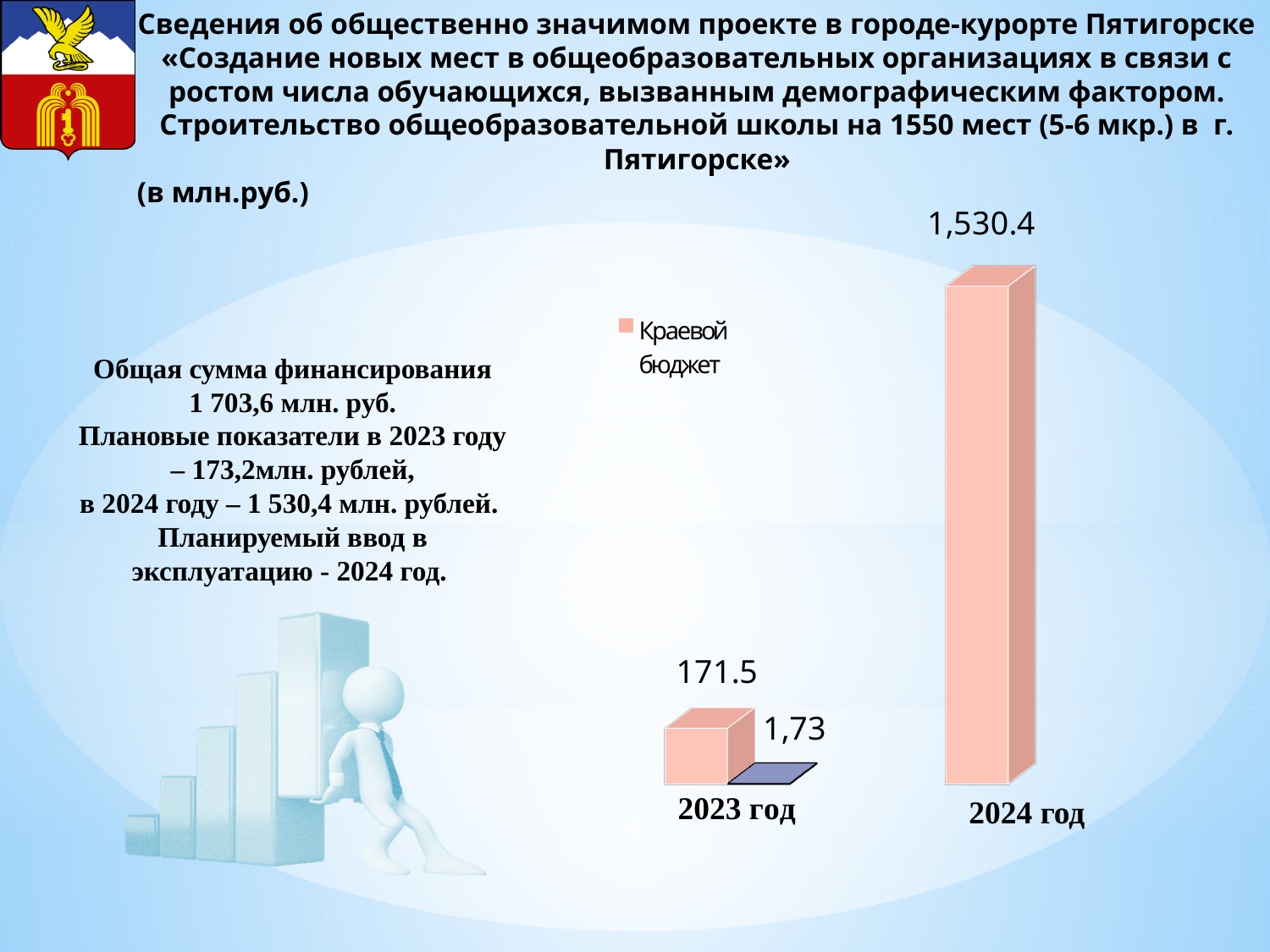
What kind of chart is shown on the slide? Bar chart How many year categories are shown on the x axis of the chart? 2 Which year has the lowest Краевой бюджет value? 2023 год Do the Краевой бюджет values rise or fall from 2023 год to 2024 год? Rise Which is larger, the Краевой бюджет value for 2023 год or for 2024 год? 2024 год Which year has the highest Краевой бюджет value? 2024 год What is the difference between the Краевой бюджет values for 2024 год and 2023 год? 1,358.9 What is the value of Краевой бюджет for 2024 год? 1,530.4 How many series does the chart legend list? 1 What is the value of Краевой бюджет for 2023 год? 171.5 What series name is shown in the chart legend? Краевой бюджет What value is labeled on the small blue bar for 2023 год? 1,73